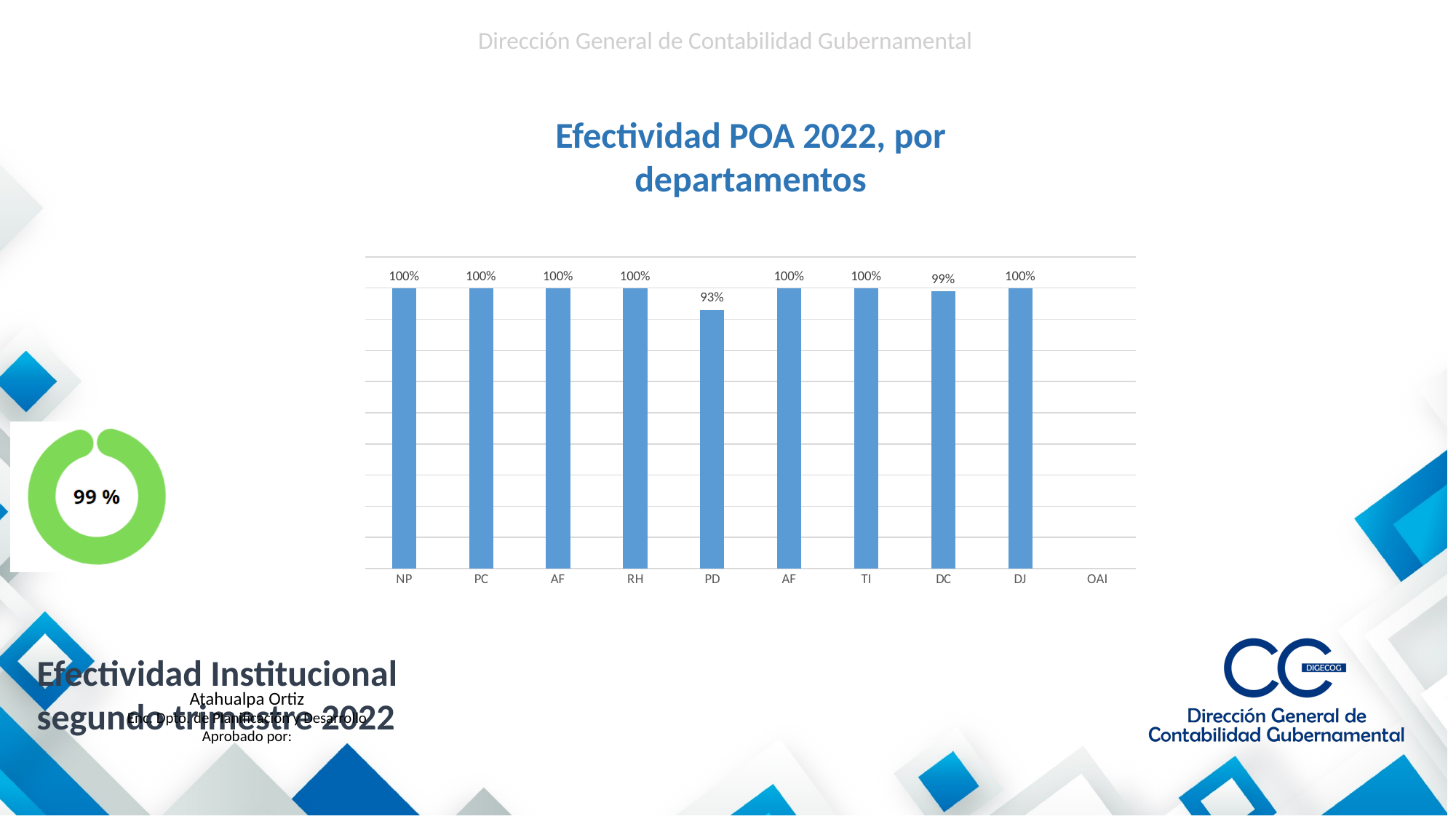
What is the value for TI in the chart? 100% Which is larger, the value for DJ or the value for DC? DJ What is the value for PD in the chart? 93% What kind of chart is shown on the slide? Bar chart What is the value for NP in the chart? 100% What is the value for DC in the chart? 99% What is the difference between the value for NP and the value for PD? 7% Which department has the lowest value in the chart? PD Which is larger, the value for DC or the value for PD? DC What is the difference between the value for DC and the value for PD? 6% What is the value for RH in the chart? 100% How many categories are listed on the x axis of the chart? 10